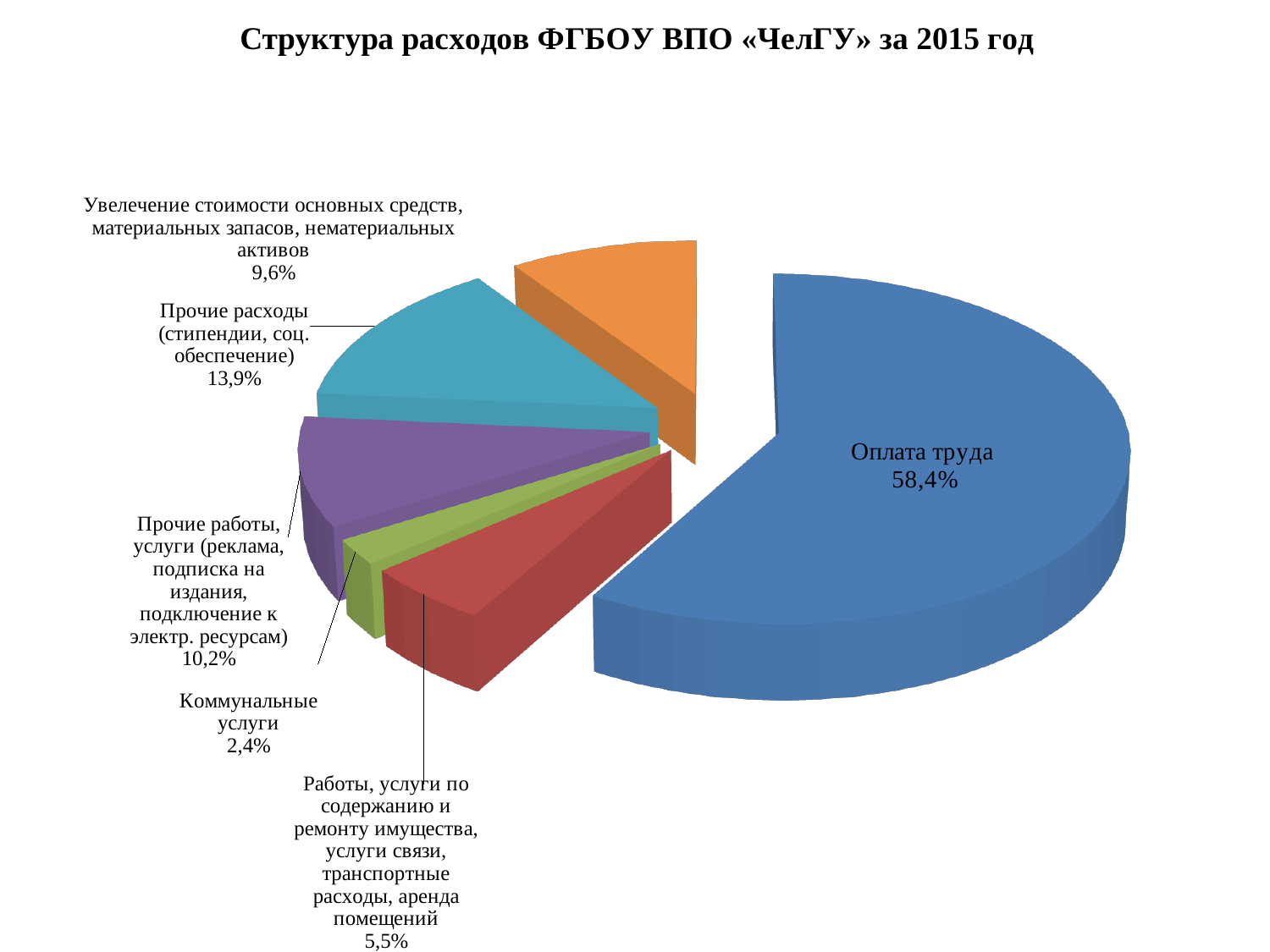
How many slices does the pie chart have? 6 What is the share of "Коммунальные услуги"? 2,4% What is the share of "Увеличение стоимости основных средств, материальных запасов, нематериальных активов"? 9,6% Which is larger: the share of "Прочие расходы (стипендии, соц. обеспечение)" or the share of "Прочие работы, услуги (реклама, подписка на издания, подключение к электр. ресурсам)"? Прочие расходы (стипендии, соц. обеспечение) Which category has the smallest share of expenses? Коммунальные услуги What is the difference in percentage points between "Оплата труда" and "Прочие расходы (стипендии, соц. обеспечение)"? 44,5 What is the share of "Прочие расходы (стипендии, соц. обеспечение)"? 13,9% What is the share of "Работы, услуги по содержанию и ремонту имущества, услуги связи, транспортные расходы, аренда помещений"? 5,5% Which category has the largest share of expenses? Оплата труда What is the title of the chart? Структура расходов ФГБОУ ВПО «ЧелГУ» за 2015 год What kind of chart is shown on the slide? Pie chart What is the share of "Оплата труда" in the pie chart? 58,4%